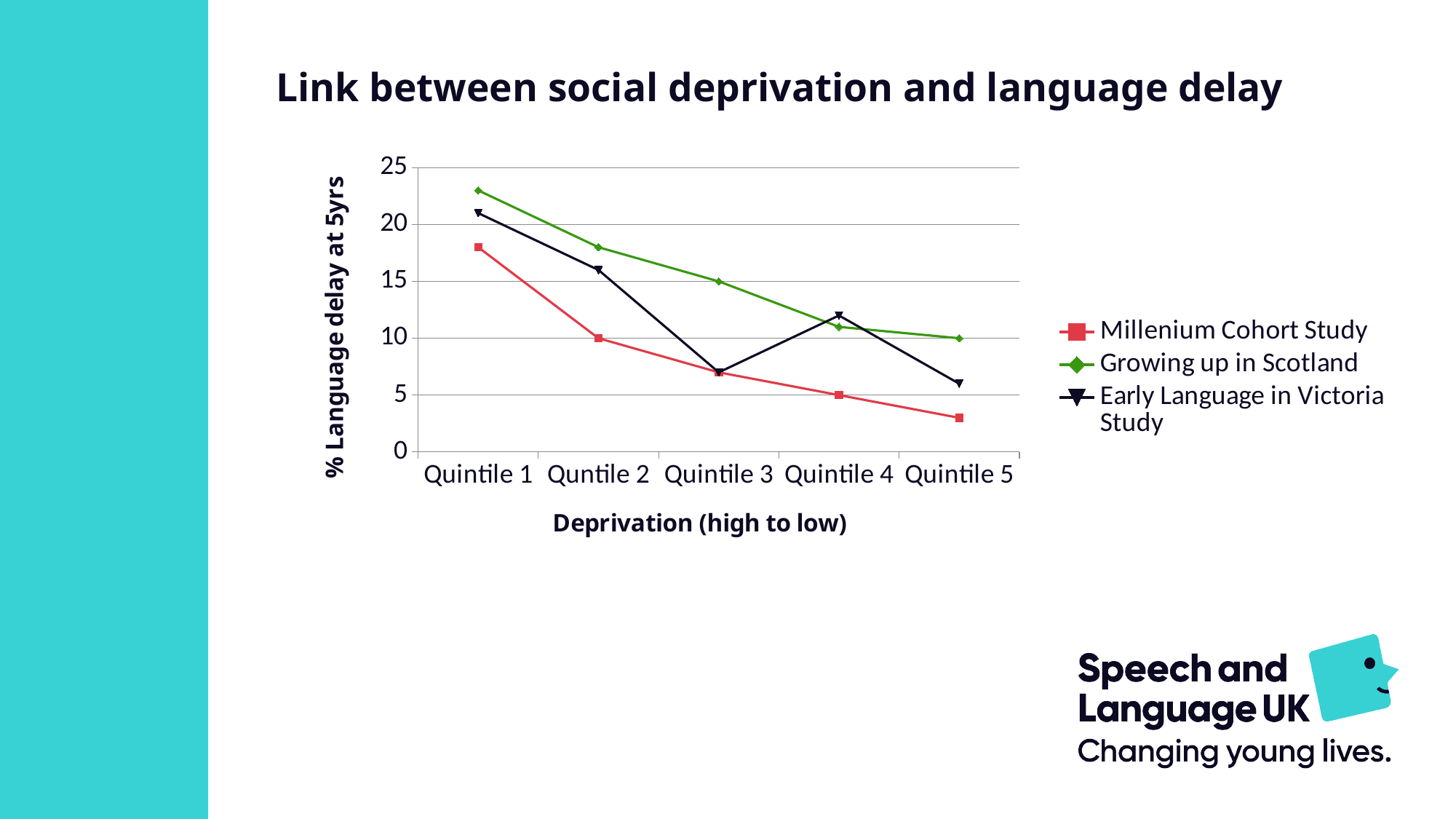
How many series does the legend list? 3 Which series has the lowest value at Quintile 5? Millenium Cohort Study What kind of chart is shown on the slide? Line chart How many quintile categories are shown on the x axis? 5 What is the label of the x axis? Deprivation (high to low) At Quintile 2, which is larger: Growing up in Scotland or the Millenium Cohort Study? Growing up in Scotland What is the value for the Millenium Cohort Study at Quintile 2? 10 Do the values for the Millenium Cohort Study rise or fall from Quintile 1 to Quintile 5? Fall Is the value for the Millenium Cohort Study at Quintile 5 greater or less than 5? less Is the value for Growing up in Scotland at Quintile 1 greater or less than 20? greater Which series has the highest value at Quintile 1? Growing up in Scotland What is the value for Growing up in Scotland at Quintile 3? 15